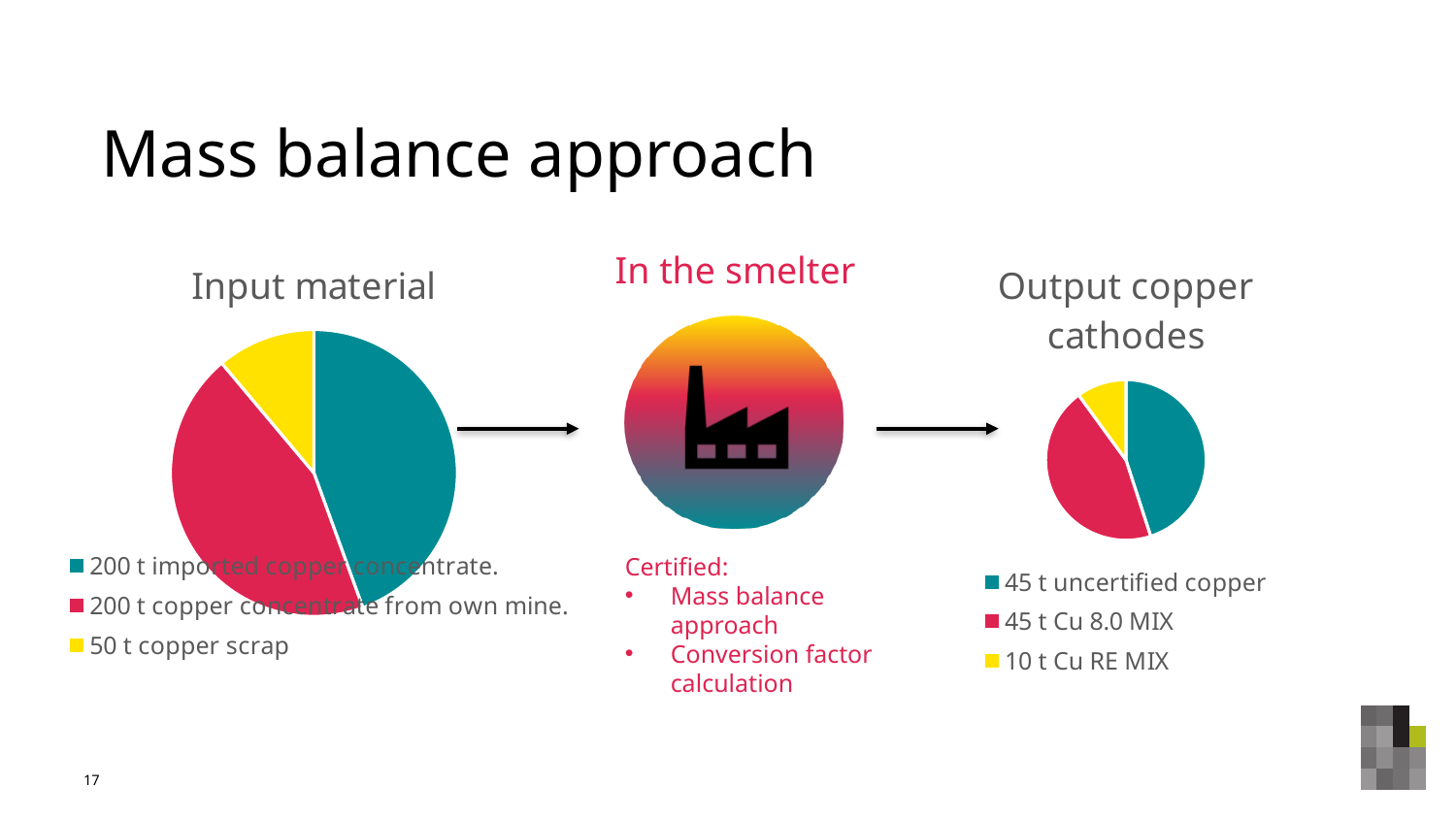
How many slices does the Input material chart have? 3 In the Input material chart, how many tonnes of imported copper concentrate are shown? 200 t In the Output copper cathodes chart, which category is the smallest? 10 t Cu RE MIX In the Output copper cathodes chart, what is the difference between Cu 8.0 MIX and Cu RE MIX? 35 t In the Input material chart, how many tonnes of copper scrap are shown? 50 t In the Input material chart, which category is the smallest? 50 t copper scrap In the Output copper cathodes chart, how many tonnes of uncertified copper are shown? 45 t In the Input material chart, what is the difference between the imported copper concentrate and the copper scrap? 150 t What kind of chart is the Input material chart? pie chart In the Output copper cathodes chart, how many tonnes of Cu RE MIX are shown? 10 t In the Output copper cathodes chart, what share of the total does Cu RE MIX represent? 10% What kind of chart is the Output copper cathodes chart? pie chart